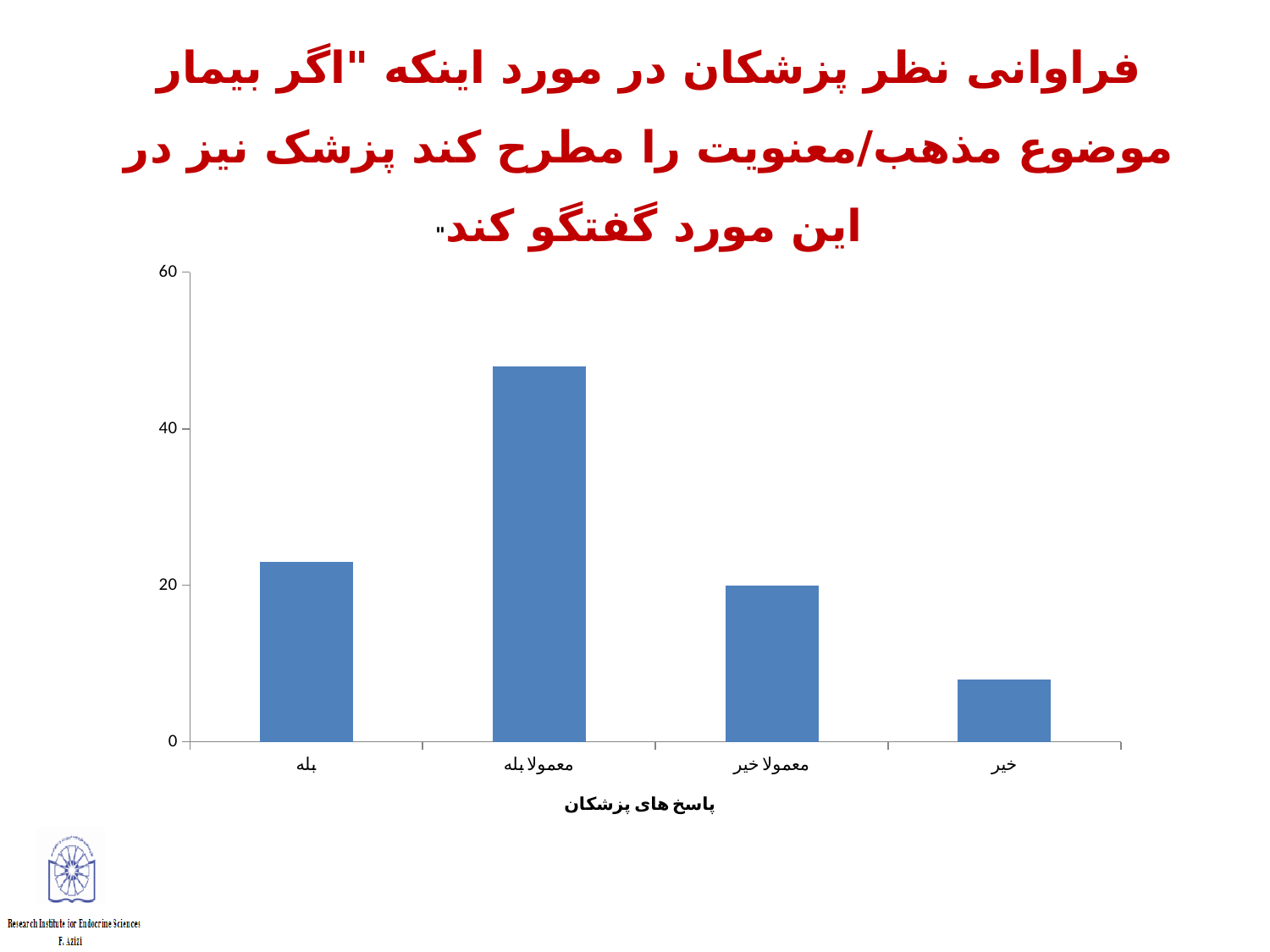
Which category has the lowest bar in the chart? خیر How many categories are shown on the x axis of the chart? 4 Is the value for معمولا بله greater or less than 40? greater Which is larger, the value for معمولا خیر or the value for خیر? معمولا خیر Which category has the highest bar in the chart? معمولا بله What kind of chart is shown on the slide? bar chart What is the title of the x axis of the chart? پاسخ های پزشکان Is the value for معمولا بله greater or less than 60? less Is the value for بله greater or less than 40? less Which is larger, the value for معمولا بله or the value for بله? معمولا بله